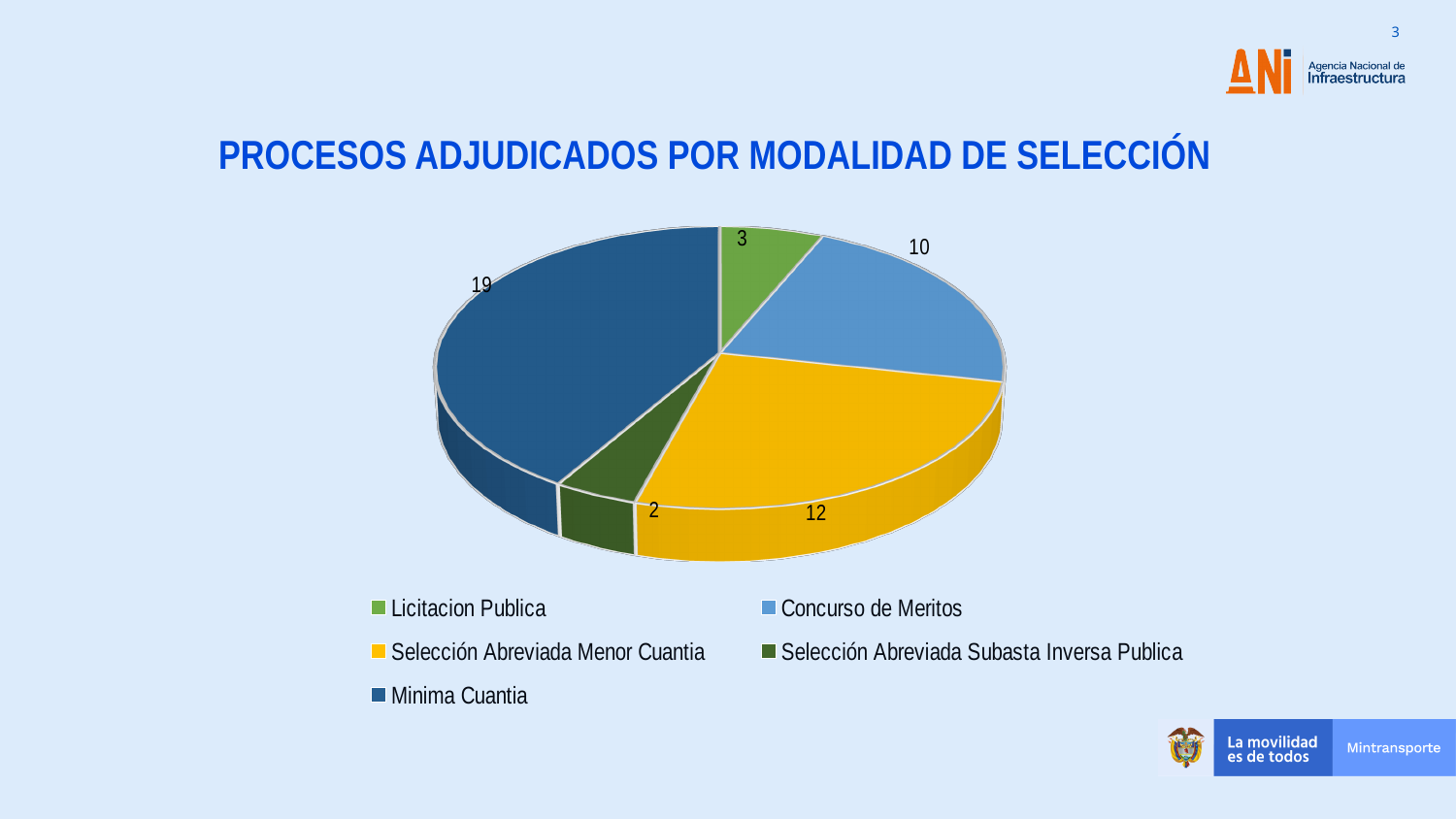
What is the value for Licitacion Publica? 3 Which is larger, the value for Concurso de Meritos or the value for Selección Abreviada Menor Cuantia? Selección Abreviada Menor Cuantia Which category has the lowest value? Selección Abreviada Subasta Inversa Publica What type of chart is shown on the slide? Pie chart What is the value for Selección Abreviada Subasta Inversa Publica? 2 Which category has the highest value? Minima Cuantia What is the title of the chart? PROCESOS ADJUDICADOS POR MODALIDAD DE SELECCIÓN What is the value for Minima Cuantia? 19 What is the value for Concurso de Meritos? 10 How many categories does the pie chart have? 5 What is the total of all the values in the pie chart? 46 What is the difference between the values for Minima Cuantia and Selección Abreviada Menor Cuantia? 7